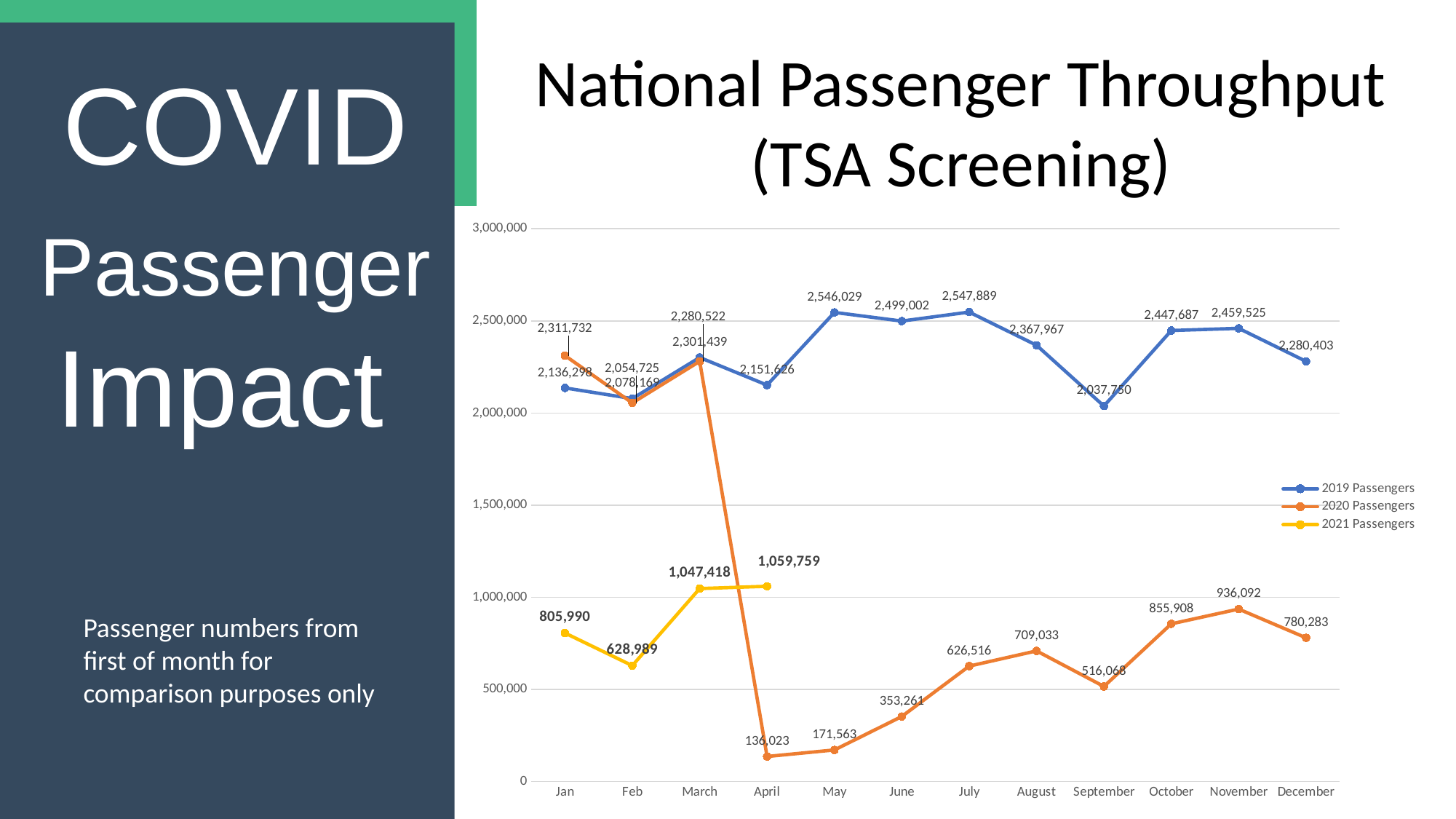
What is the difference between 2019 Passengers and 2020 Passengers in May? 2,374,466 How many series does the legend list? 3 Which is larger in April: 2020 Passengers or 2021 Passengers? 2021 Passengers What is the value for 2020 Passengers in April? 136,023 What kind of chart is shown on the slide? line chart Do the 2020 Passengers values rise or fall from April to August? rise Is the value for 2020 Passengers in November greater or less than 1,000,000? less In which month is the 2020 Passengers value highest? Jan How many months are shown along the x axis? 12 What is the value for 2021 Passengers in March? 1,047,418 In which month is the 2020 Passengers value lowest? April What is the value for 2019 Passengers in December? 2,280,403